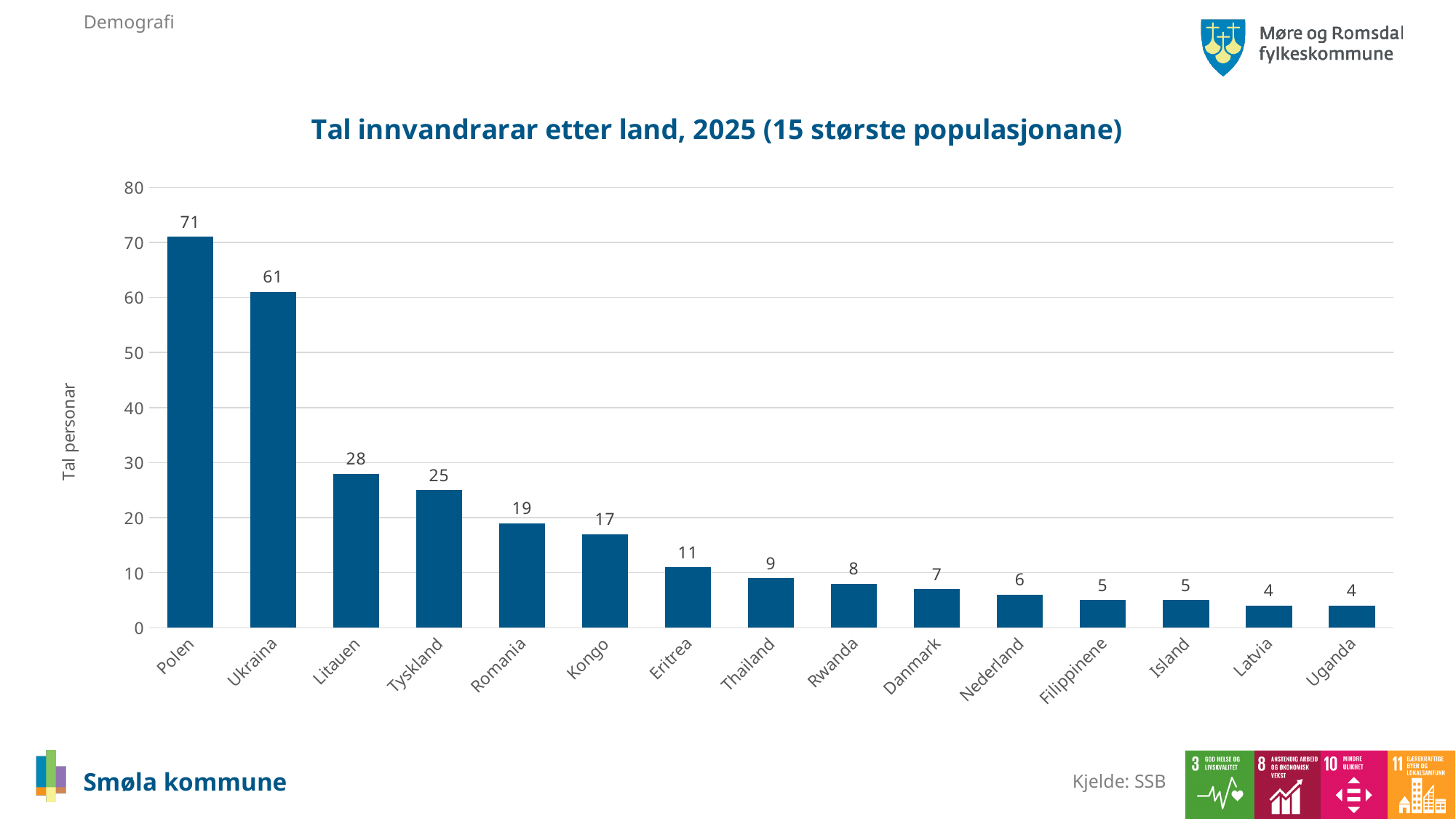
What is the value for Tyskland? 25 Is the value for Ukraina greater or less than 50? greater What is the value for Eritrea? 11 What is the difference between the values for Polen and Ukraina? 10 What is the difference between the values for Litauen and Tyskland? 3 How many countries are shown on the chart? 15 What is the value for Polen? 71 What kind of chart is shown on the slide? Bar chart Which country has the highest value? Polen Which is larger, the value for Romania or the value for Kongo? Romania What is the title of the chart? Tal innvandrarar etter land, 2025 (15 største populasjonane) Which country has the lowest value, Latvia or Uganda? They are equal (4)